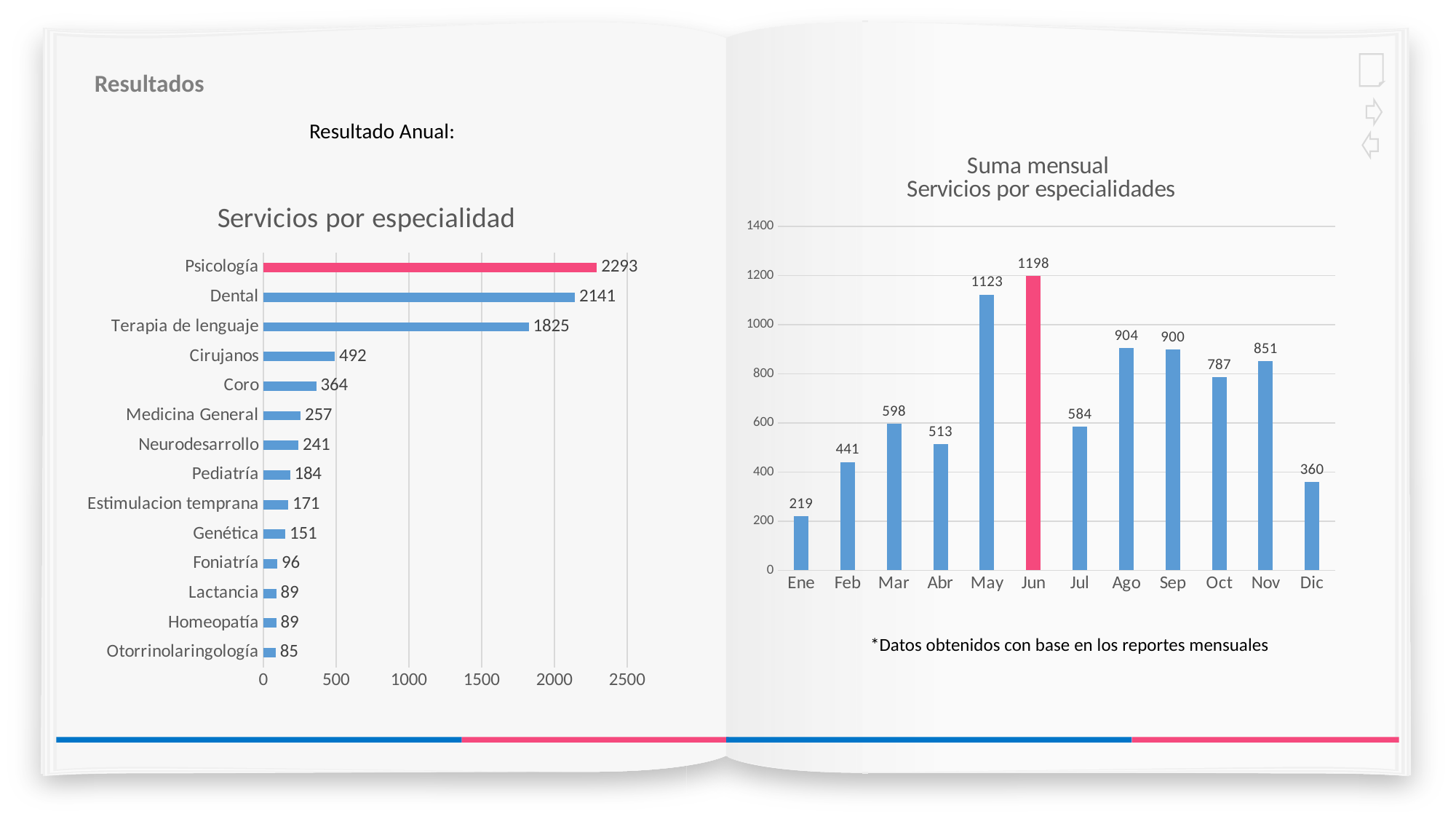
In the 'Suma mensual Servicios por especialidades' chart, which month has the lowest value? Ene In the 'Servicios por especialidad' chart, which is larger, Cirujanos or Coro? Cirujanos In the 'Suma mensual Servicios por especialidades' chart, what is the value for Oct? 787 In the 'Servicios por especialidad' chart, which bar is coloured pink instead of blue? Psicología In the 'Servicios por especialidad' chart, what is the value for Dental? 2141 In the 'Servicios por especialidad' chart, how many specialties are shown? 14 In the 'Servicios por especialidad' chart, what is the difference between Psicología and Dental? 152 In the 'Suma mensual Servicios por especialidades' chart, what is the difference between May and Jun? 75 In the 'Servicios por especialidad' chart, which specialty has the lowest value? Otorrinolaringología In the 'Suma mensual Servicios por especialidades' chart, which month has the highest value? Jun In the 'Servicios por especialidad' chart, which specialty has the highest value? Psicología What kind of chart is the 'Suma mensual Servicios por especialidades' chart? Bar chart